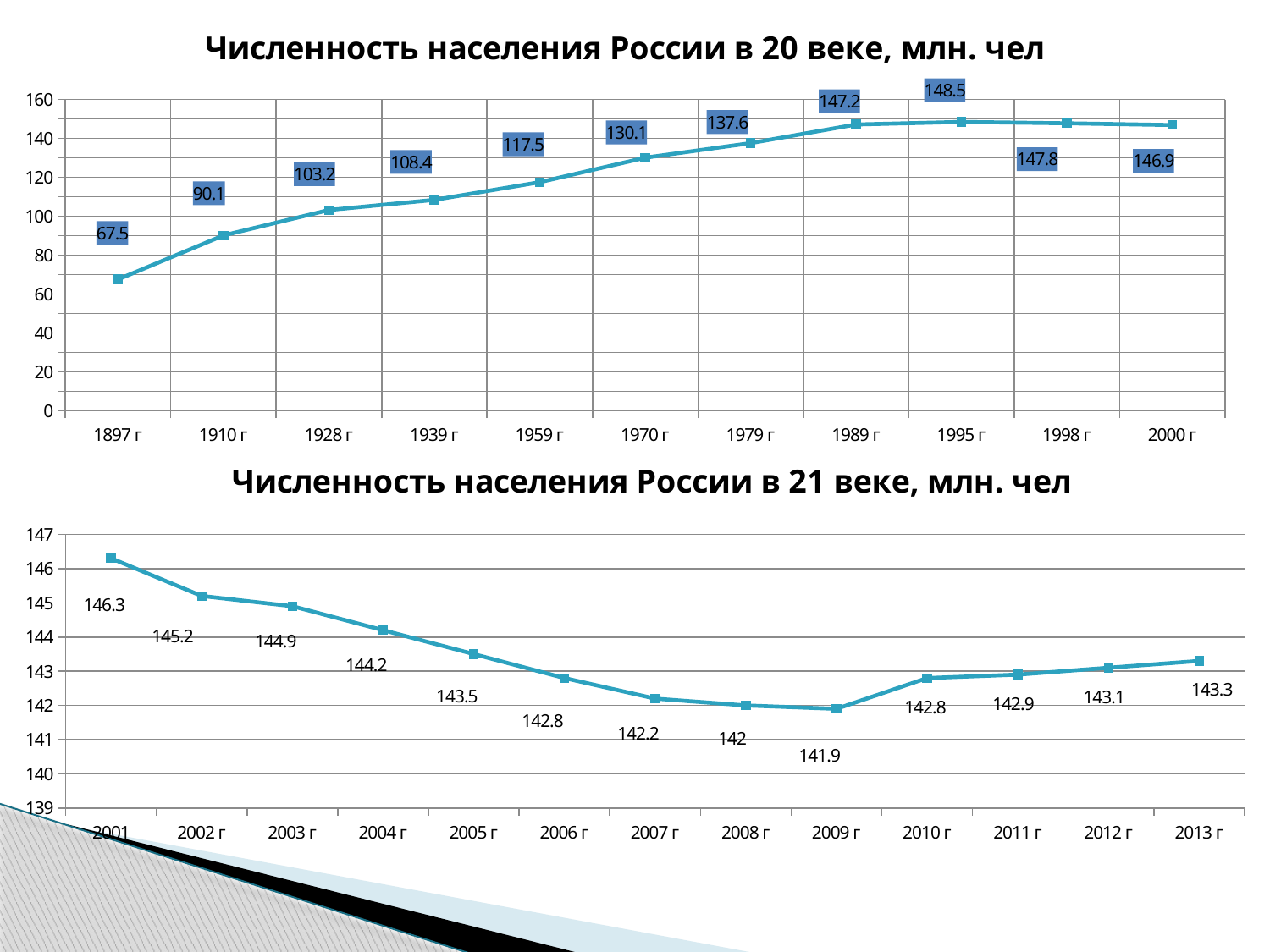
In the chart 'Численность населения России в 21 веке, млн. чел', do the values rise or fall from 2001 to 2009 г? Fall In the chart 'Численность населения России в 21 веке, млн. чел', which year has the highest value? 2001 In the chart 'Численность населения России в 21 веке, млн. чел', what is the value for 2009 г? 141.9 In the chart 'Численность населения России в 21 веке, млн. чел', which year has the lowest value? 2009 г What type of chart is the top chart on the slide? Line chart In the chart 'Численность населения России в 21 веке, млн. чел', which is larger, the value for 2004 г or the value for 2012 г? 2004 г In the chart 'Численность населения России в 20 веке, млн. чел', which year has the highest value? 1995 г In the chart 'Численность населения России в 20 веке, млн. чел', what is the value for 1897 г? 67.5 In the chart 'Численность населения России в 20 веке, млн. чел', what is the difference between the values for 1970 г and 1959 г? 12.6 In the chart 'Численность населения России в 20 веке, млн. чел', which year has the lowest value? 1897 г In the chart 'Численность населения России в 20 веке, млн. чел', how many data points are plotted? 11 In the chart 'Численность населения России в 21 веке, млн. чел', how many years are shown on the x axis? 13